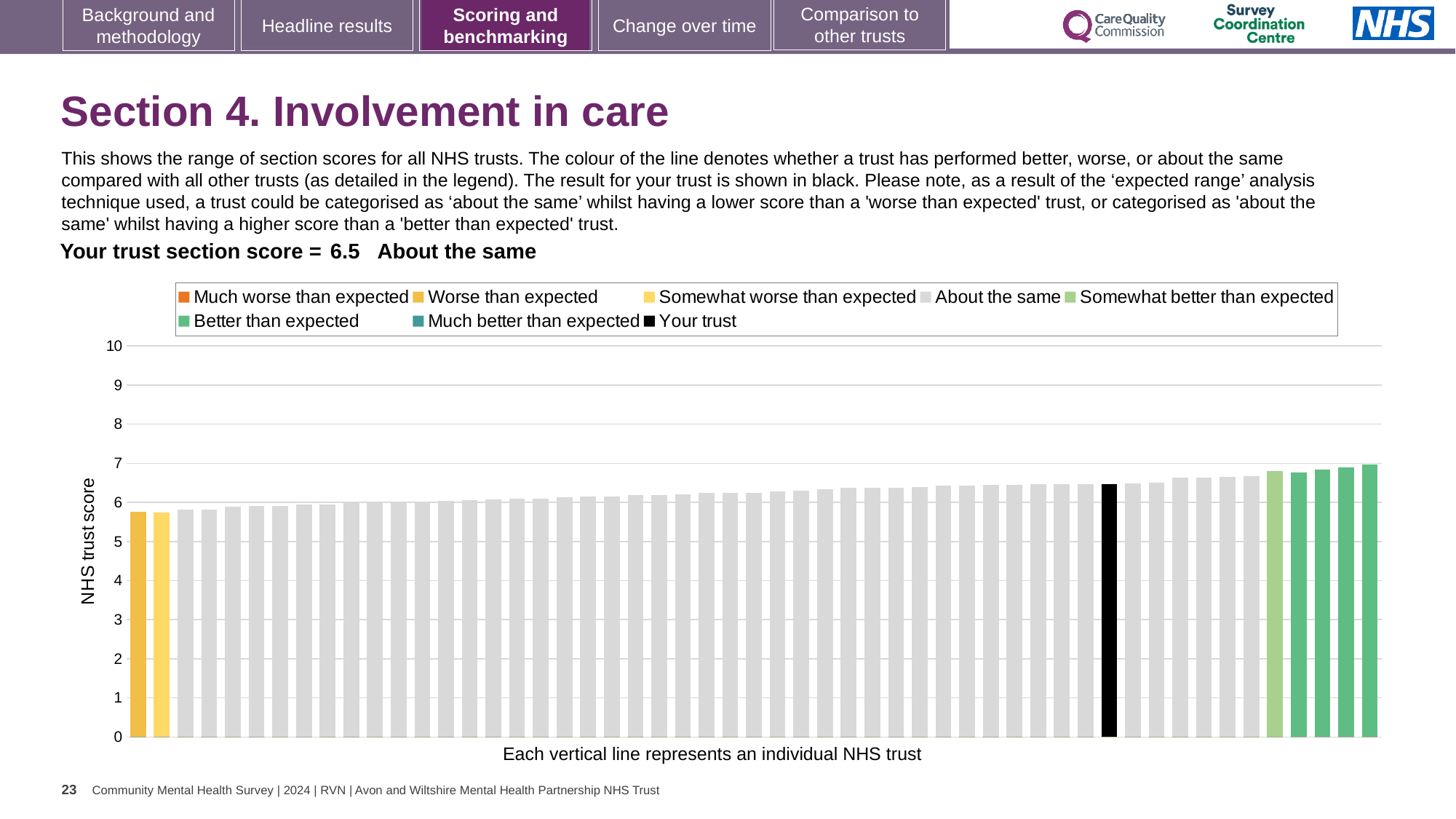
Is the value for your trust greater or less than 5? greater Is the value for the highest bar greater or less than 6? greater What is the label on the vertical axis of the chart? NHS trust score Do the bar values rise or fall from left to right along the x axis? rise What is the section score for your trust? 6.5 What colour is the bar representing your trust? black Is the value for the lowest bar greater or less than 6? less Which performance category is your trust placed in for this section? About the same How many entries does the chart legend list? 8 Which legend category do the highest bars on the right belong to? Better than expected What kind of chart is shown on the slide? bar chart